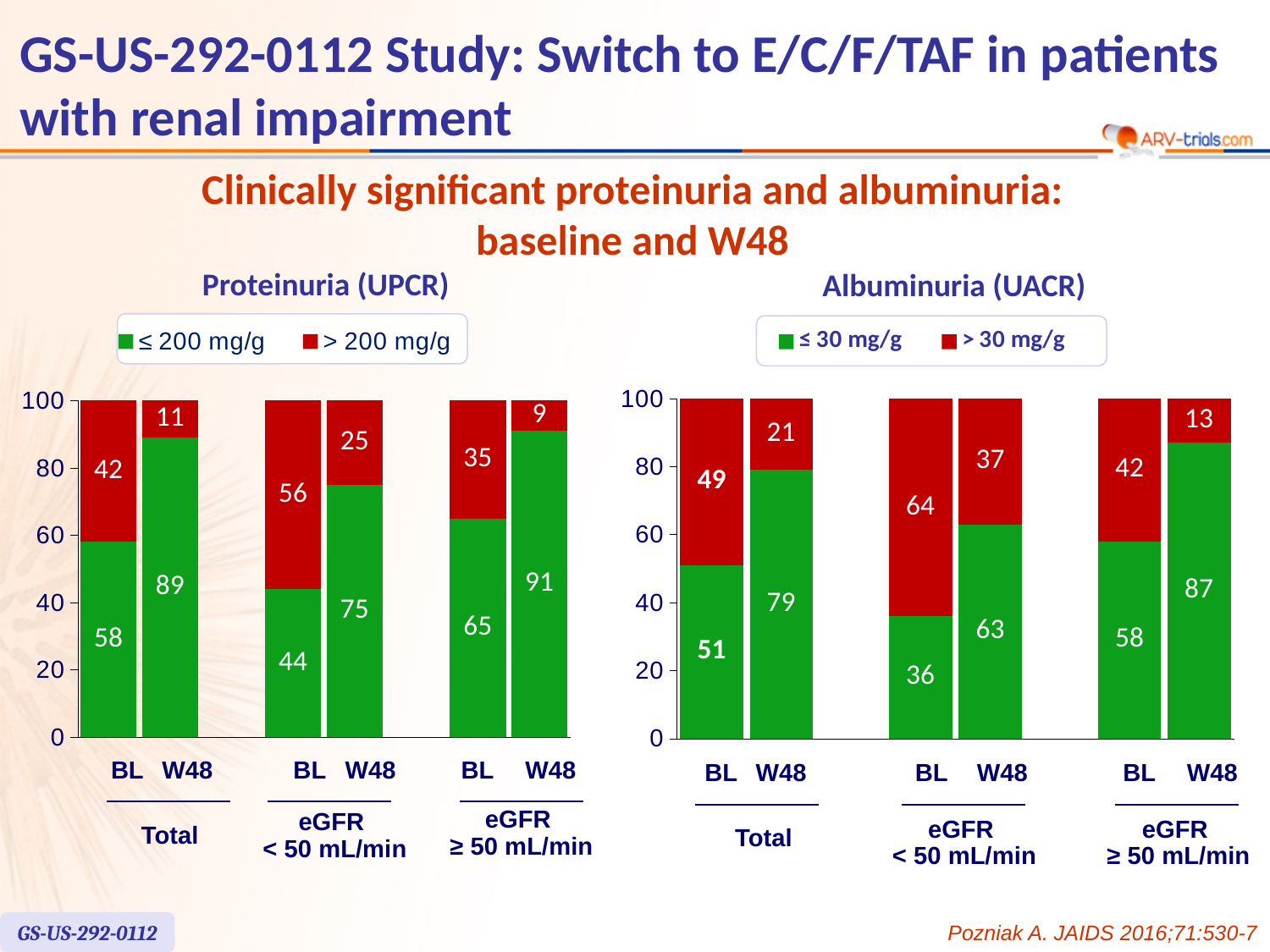
In the Albuminuria (UACR) chart, what is the total of the stacked bar for the eGFR < 50 mL/min group at W48? 100 In the Albuminuria (UACR) chart, what is the value of the ≤ 30 mg/g segment for the eGFR < 50 mL/min group at baseline (BL)? 36 In the Proteinuria (UPCR) chart, what is the value of the ≤ 200 mg/g segment for the Total group at W48? 89 How many series does the legend of the Proteinuria (UPCR) chart list? 2 In the Proteinuria (UPCR) chart, what is the difference between the ≤ 200 mg/g values at W48 and BL for the Total group? 31 How many bars are plotted in the Albuminuria (UACR) chart? 6 In the Albuminuria (UACR) chart, which bar has the lowest ≤ 30 mg/g value? eGFR < 50 mL/min BL In the Proteinuria (UPCR) chart, what is the value of the > 200 mg/g segment for the eGFR < 50 mL/min group at baseline (BL)? 56 In the Proteinuria (UPCR) chart, which bar has the highest ≤ 200 mg/g value? eGFR ≥ 50 mL/min W48 In the Albuminuria (UACR) chart, what is the value of the > 30 mg/g segment for the eGFR ≥ 50 mL/min group at W48? 13 In the Albuminuria (UACR) chart, which is larger: the > 30 mg/g value for the Total group at BL or for the eGFR ≥ 50 mL/min group at BL? Total BL What type of chart is the Proteinuria (UPCR) chart? Stacked bar chart